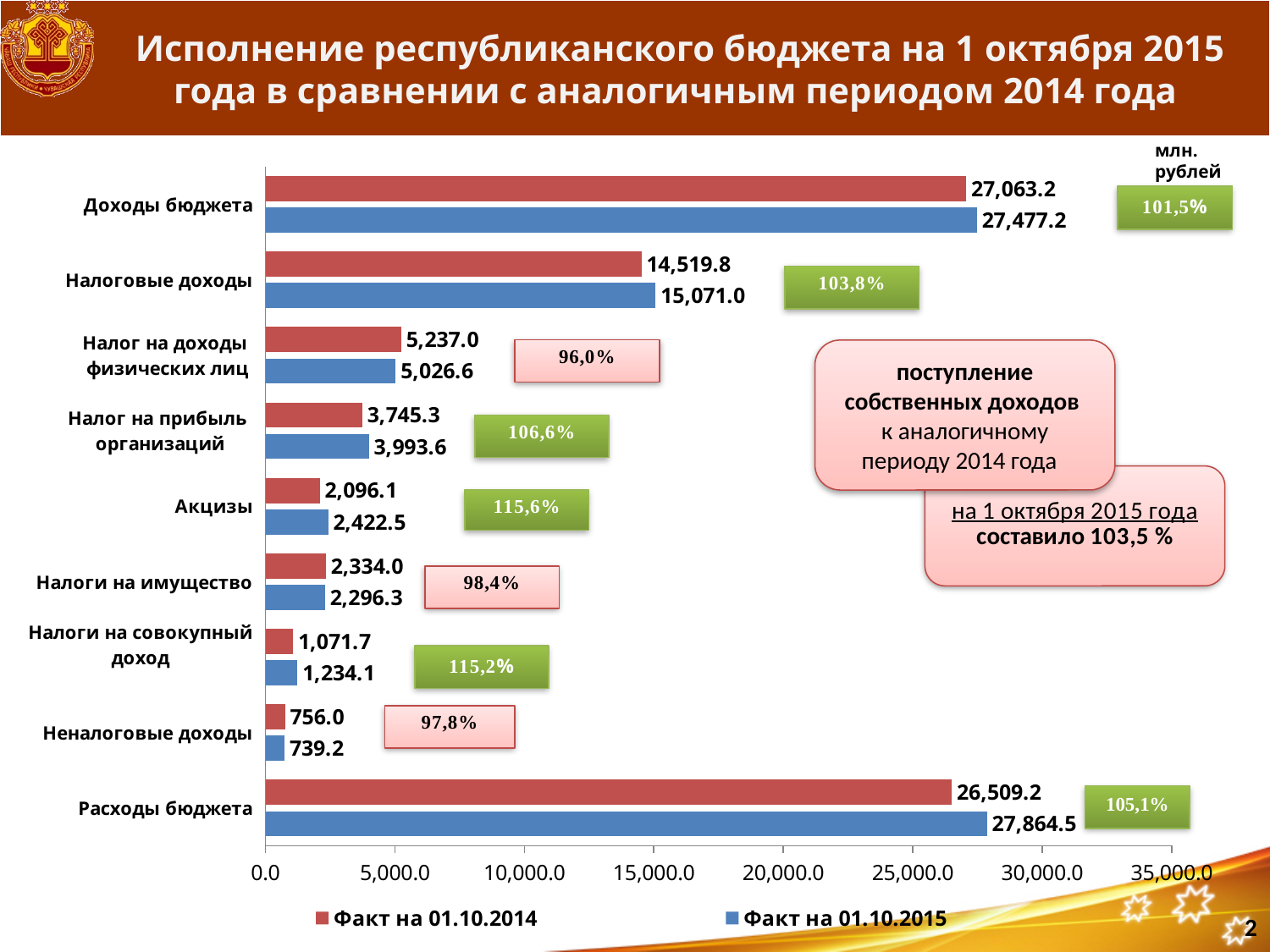
How many categories are shown on the chart? 9 What kind of chart is shown on the slide? bar chart For Налог на доходы физических лиц, which series has the larger value: Факт на 01.10.2014 or Факт на 01.10.2015? Факт на 01.10.2014 Is the value for Расходы бюджета in the Факт на 01.10.2015 series greater or less than 25,000.0? greater What is the value for Акцизы in the Факт на 01.10.2014 series? 2,096.1 What is the value for Доходы бюджета in the Факт на 01.10.2015 series? 27,477.2 Which category has the lowest value in the Факт на 01.10.2014 series? Неналоговые доходы What is the difference between the Факт на 01.10.2015 and Факт на 01.10.2014 values for Расходы бюджета? 1,355.3 Which category has the highest value in the Факт на 01.10.2015 series? Расходы бюджета How many series does the legend list? 2 What is the value for Неналоговые доходы in the Факт на 01.10.2015 series? 739.2 What is the difference between the Факт на 01.10.2015 and Факт на 01.10.2014 values for Доходы бюджета? 414.0